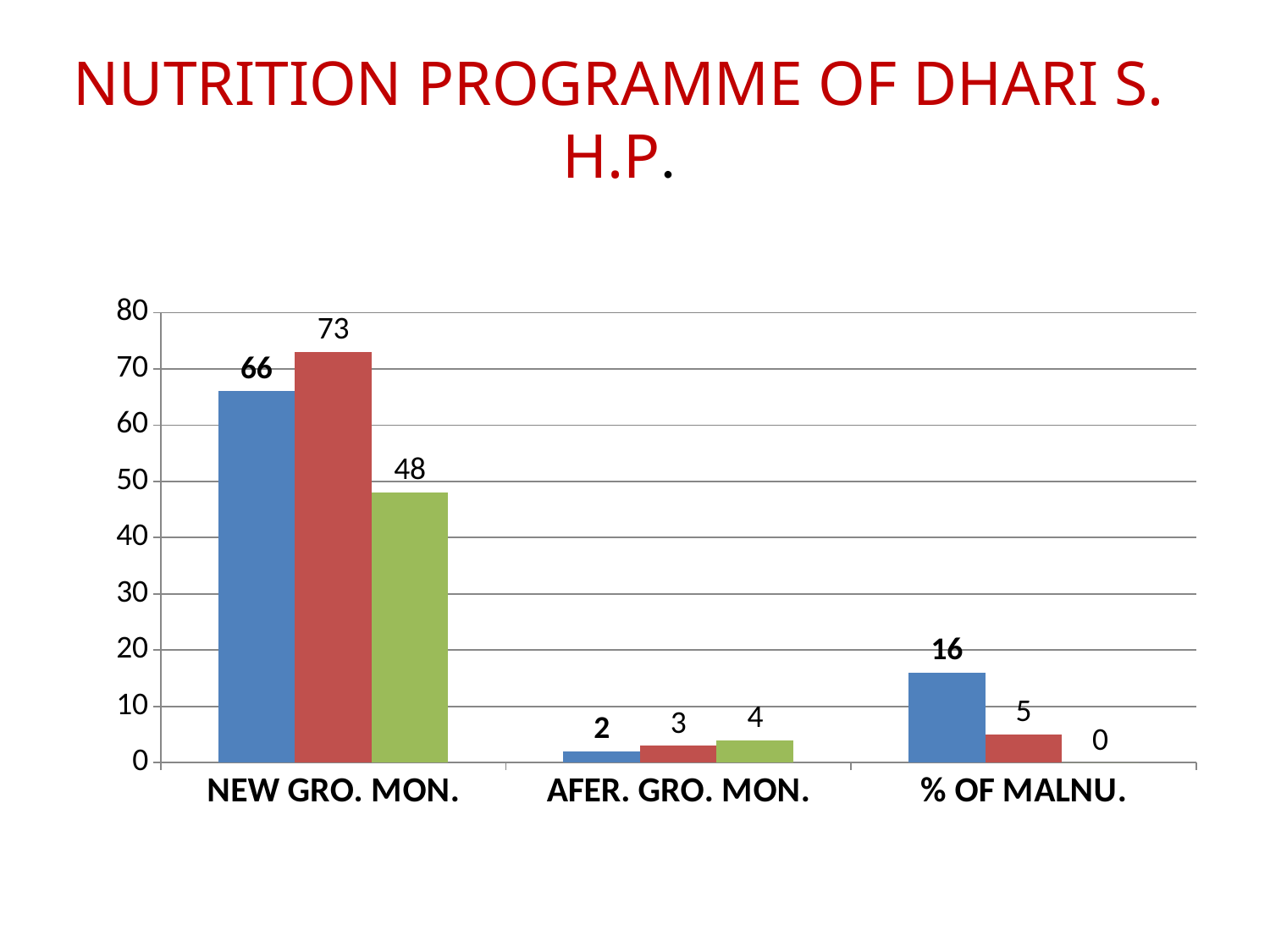
What is the value of the green bar for % OF MALNU.? 0 What is the value of the blue bar for % OF MALNU.? 16 What is the title of the slide containing the chart? NUTRITION PROGRAMME OF DHARI S. H.P. What is the value of the blue bar for NEW GRO. MON.? 66 What is the difference between the red and green bars for NEW GRO. MON.? 25 Which is larger for AFER. GRO. MON., the blue bar or the green bar? the green bar Which category has the lowest green bar? % OF MALNU. What is the value of the red bar for NEW GRO. MON.? 73 What kind of chart is shown on the slide? bar chart Which category has the highest blue bar? NEW GRO. MON. Do the blue bars rise or fall from NEW GRO. MON. to AFER. GRO. MON.? fall How many categories are shown on the x axis? 3